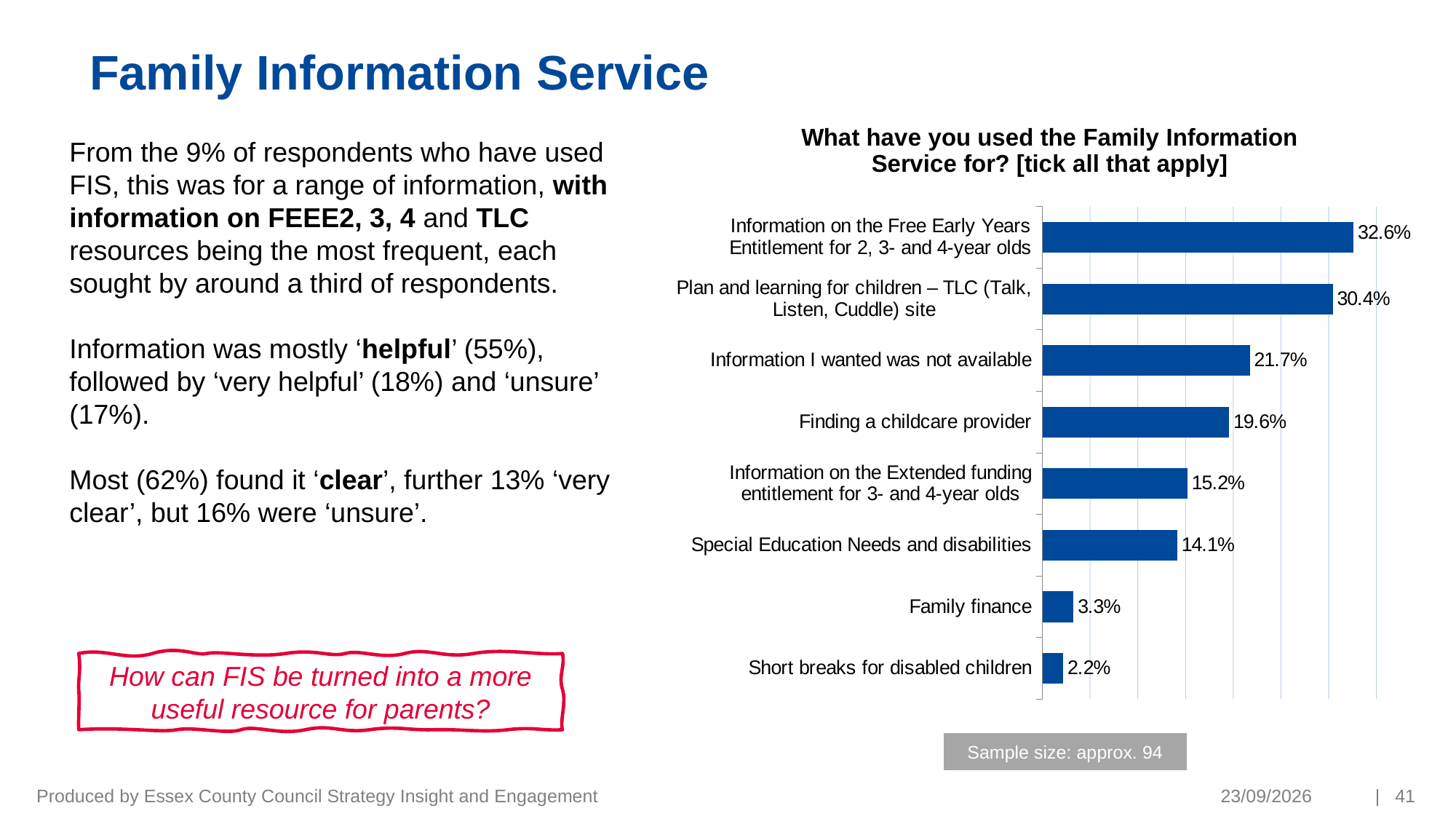
Which category has the lowest value in the chart? Short breaks for disabled children What sample size is stated below the chart? approx. 94 What is the difference between the top two categories, Free Early Years Entitlement and the TLC site? 2.2% How many categories are shown in the chart? 8 Which category has the highest value in the chart? Information on the Free Early Years Entitlement for 2, 3- and 4-year olds Which is larger: the value for 'Finding a childcare provider' or for 'Information on the Extended funding entitlement for 3- and 4-year olds'? Finding a childcare provider What percentage is shown for 'Information I wanted was not available'? 21.7% What is the value shown for 'Special Education Needs and disabilities'? 14.1% What percentage of respondents used the Family Information Service for finding a childcare provider? 19.6% What is the title of the chart? What have you used the Family Information Service for? [tick all that apply] What kind of chart is shown on the slide? Bar chart What is the difference between the values for 'Family finance' and 'Short breaks for disabled children'? 1.1%